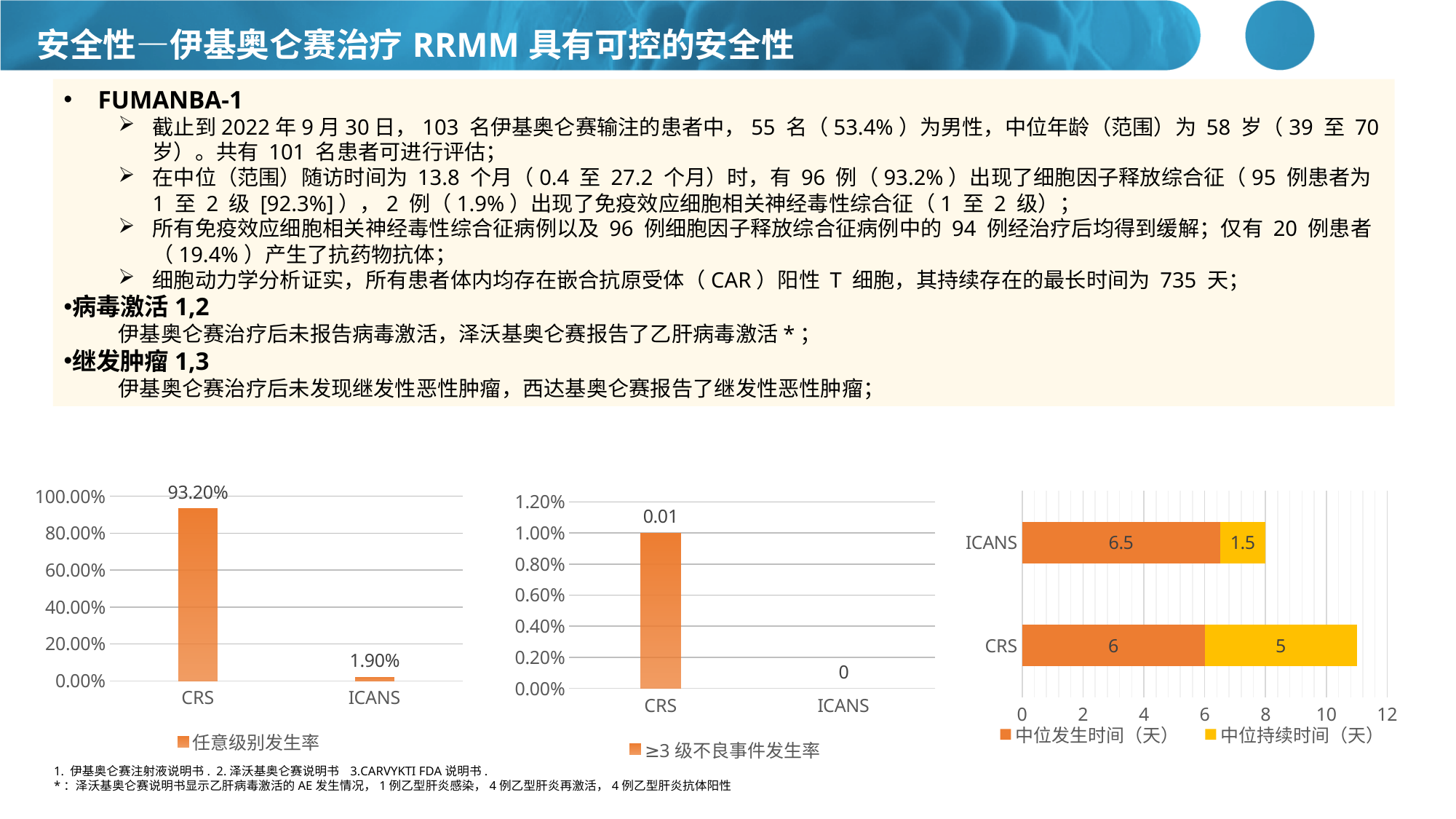
In the right chart, what is the 中位发生时间（天） value for ICANS? 6.5 In the right chart, what is the total length of the stacked bar for ICANS? 8 How many series does the legend of the right chart list? 2 In the left chart (任意级别发生率), what is the value for CRS? 93.20% In the right chart, what is the total length of the stacked bar for CRS? 11 In the middle chart (≥3 级不良事件发生率), what data label is shown for CRS? 0.01 In the middle chart (≥3 级不良事件发生率), what data label is shown for ICANS? 0 In the left chart (任意级别发生率), what is the value for ICANS? 1.90% In the right chart, what is the 中位持续时间（天） value for CRS? 5 In the left chart (任意级别发生率), what is the difference between the CRS and ICANS values? 91.30% In the middle chart (≥3 级不良事件发生率), which category has the lowest value? ICANS In the left chart (任意级别发生率), which category has the highest value? CRS